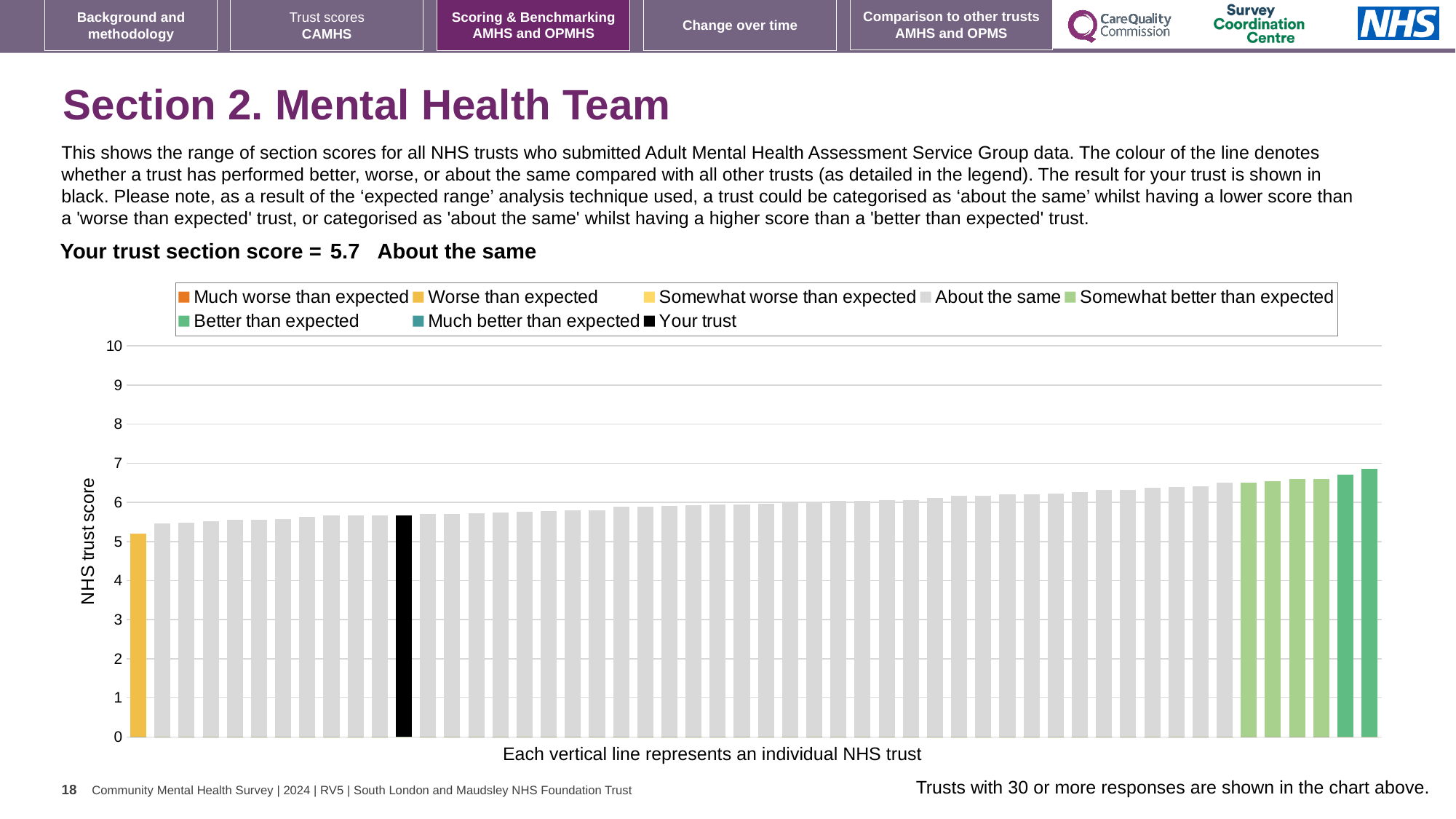
Do the bar values rise or fall from left to right along the x axis? rise Is the value of the leftmost bar greater or less than 6? less What colour is the bar representing your trust in the chart? black Which category is your trust placed in according to the slide? About the same What kind of chart is shown on the slide? bar chart What is the section score for your trust shown on the slide? 5.7 How many entries does the chart legend list? 8 What is the label on the vertical axis of the chart? NHS trust score Which bar is larger, the leftmost bar or the rightmost bar? the rightmost bar Is the value of the rightmost bar greater or less than 7? less Is the value of the black 'Your trust' bar greater or less than 5? greater